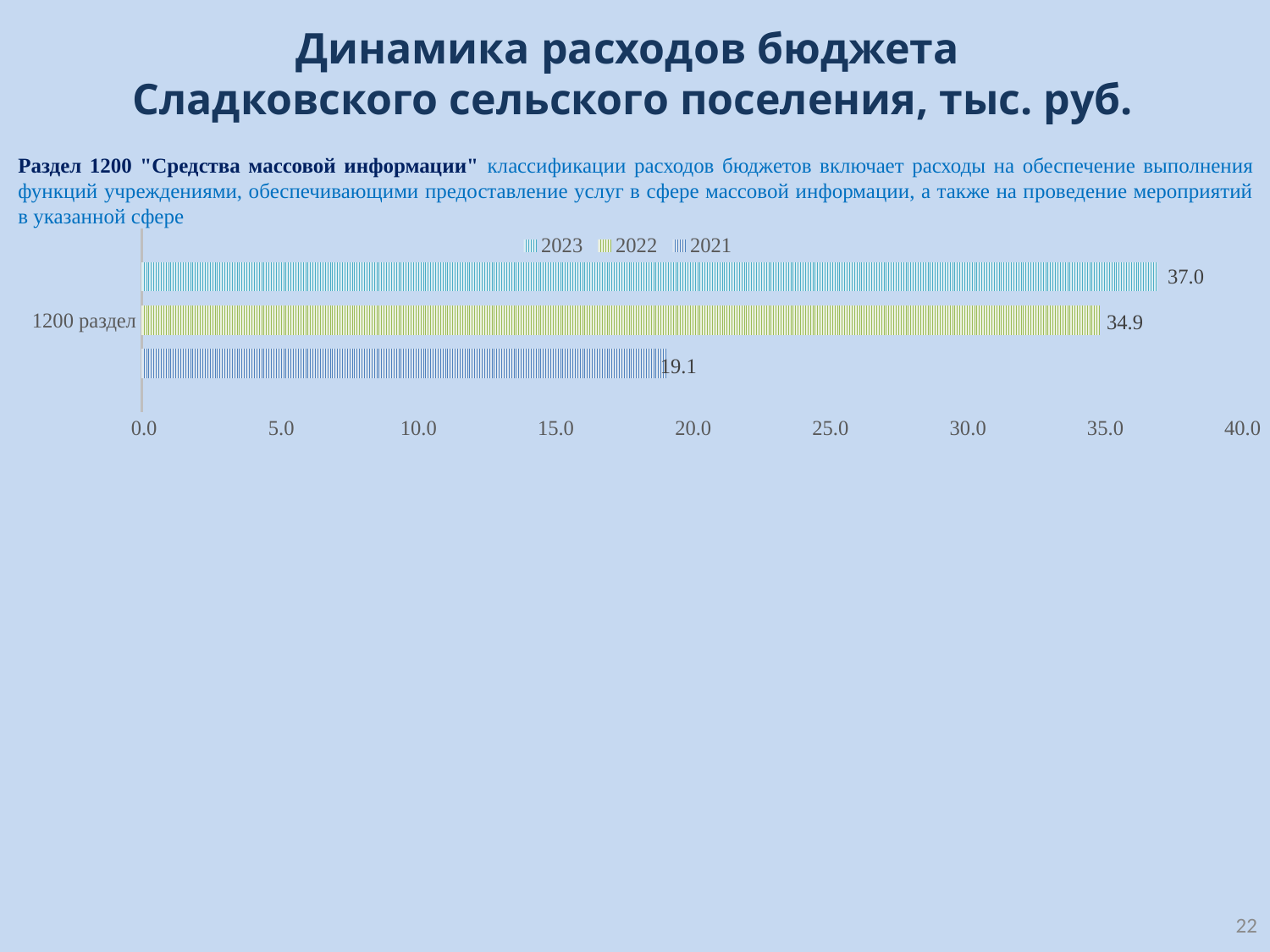
Which is larger for "1200 раздел": the 2022 value or the 2021 value? 2022 What is the value for 2023 for the category "1200 раздел"? 37.0 What kind of chart is shown on the slide? bar chart What is the value for 2021 for the category "1200 раздел"? 19.1 How many series does the legend list? 3 What is the value for 2022 for the category "1200 раздел"? 34.9 Which year has the lowest value for "1200 раздел"? 2021 What is the difference between the 2023 and 2022 values for "1200 раздел"? 2.1 Which year has the highest value for "1200 раздел"? 2023 Is the value for 2021 greater or less than 20.0? less What is the difference between the 2023 and 2021 values for "1200 раздел"? 17.9 What is the label of the category shown on the vertical axis of the chart? 1200 раздел